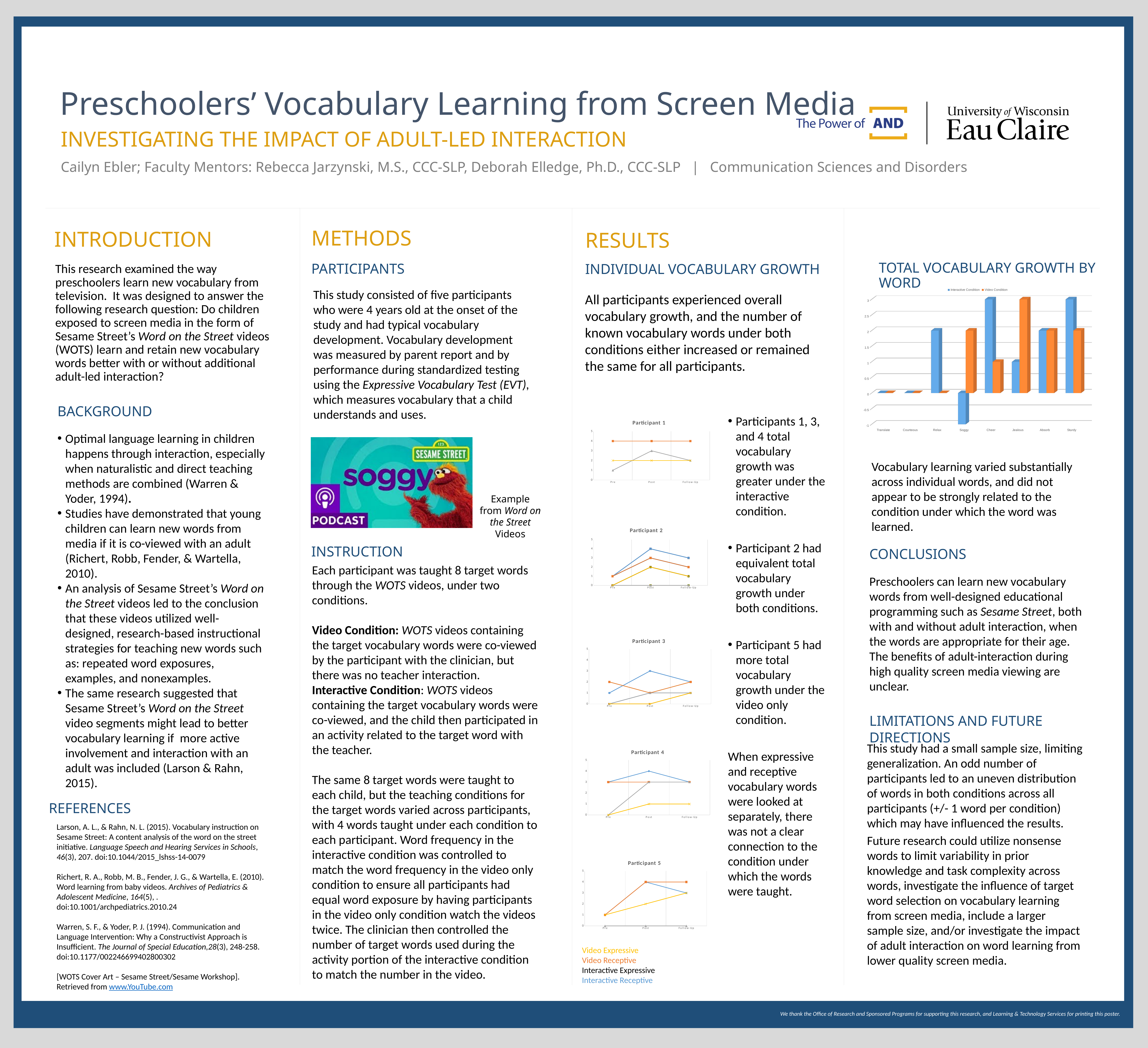
In the "Total Vocabulary Growth by Word" chart, which word has the lowest Interactive Condition value? Soggy What kind of chart is the "Total Vocabulary Growth by Word" chart? bar chart In the "Total Vocabulary Growth by Word" chart, is the Interactive Condition value for Soggy greater or less than 0? less How many series does the legend of the "Total Vocabulary Growth by Word" chart list? 2 How many time points are shown on the x axis of the "Participant 5" chart? 3 In the "Total Vocabulary Growth by Word" chart, is the Interactive Condition value for Cheer greater or less than 2? greater In the "Total Vocabulary Growth by Word" chart, which condition has the higher value for Cheer? Interactive Condition How many words (categories) are shown on the x axis of the "Total Vocabulary Growth by Word" chart? 8 What are the two legend entries of the "Total Vocabulary Growth by Word" chart? Interactive Condition and Video Condition In the "Total Vocabulary Growth by Word" chart, is the Video Condition value for Jealous greater or less than 2? greater What kind of chart is the "Participant 1" chart? line chart In the "Total Vocabulary Growth by Word" chart, which condition has the higher value for Soggy? Video Condition